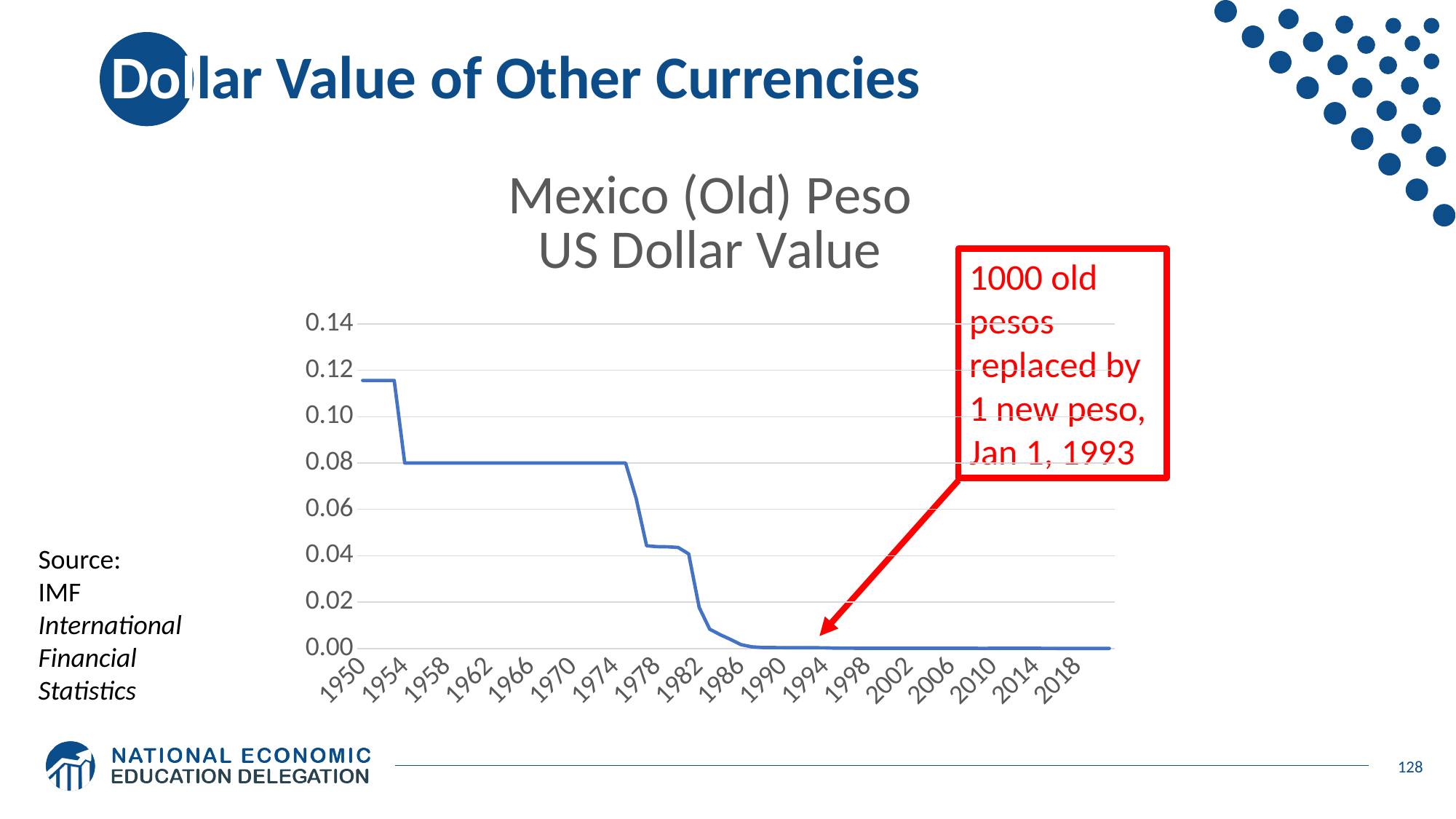
Is the value for 1962 greater or less than 0.10? less Is the value for 1980 greater or less than 0.06? less What is the title of the chart? Mexico (Old) Peso US Dollar Value Is the value for 1950 greater or less than 0.10? greater What kind of chart is shown on the slide? line chart In which year shown on the x axis is the value highest? 1950 Overall, does the US dollar value of the Mexican old peso rise or fall from 1950 to 2018? fall What is the highest value shown on the y axis? 0.14 Which is larger, the value for 1958 or the value for 1986? 1958 How many year labels are shown on the x axis? 18